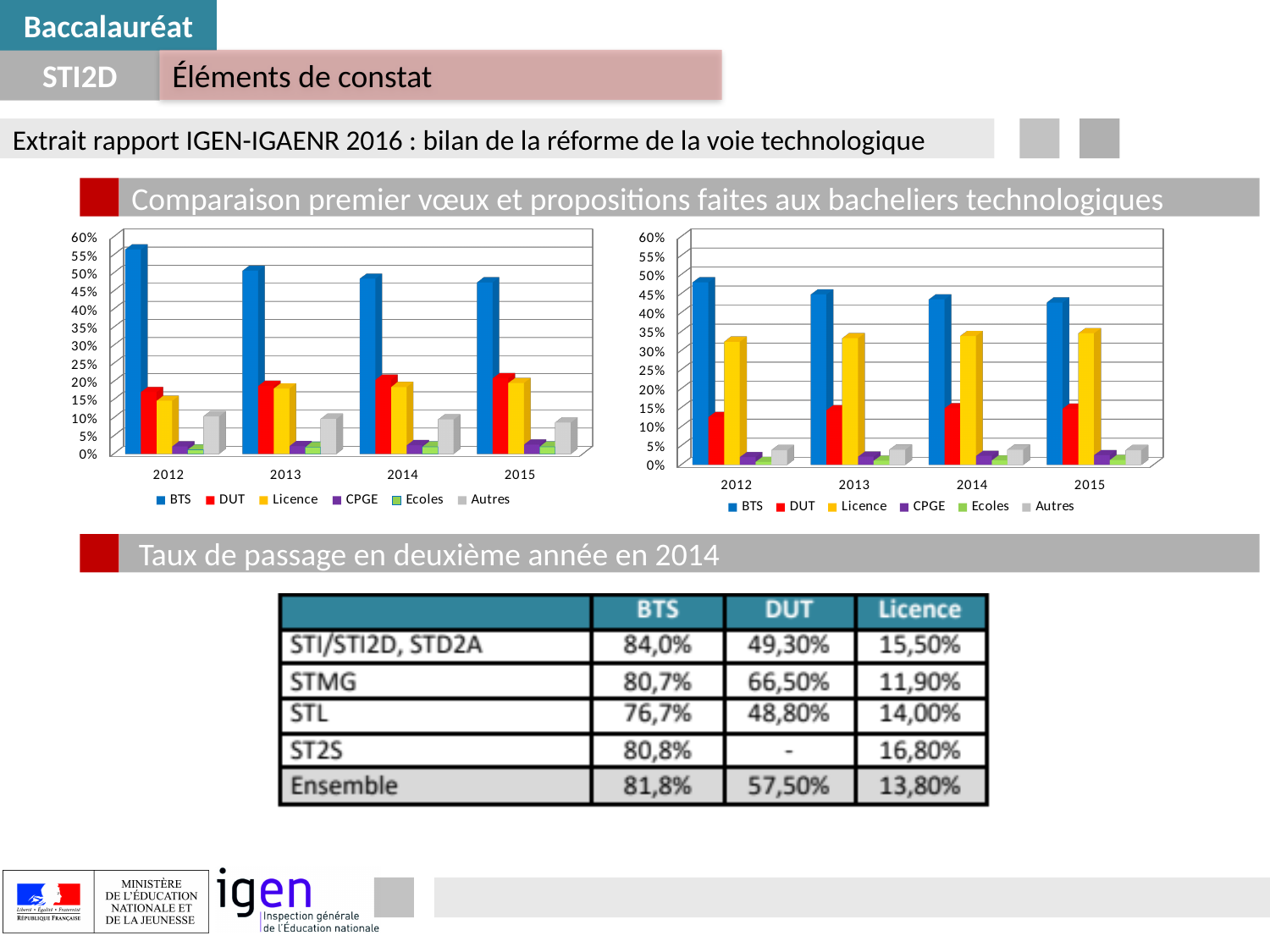
In the left chart, which series has the highest value in 2012? BTS In the right chart, which series has the highest value in 2015? BTS What colour are the BTS bars in the left chart? blue In the left chart, does the BTS value rise or fall from 2012 to 2015? fall In the left chart, is the value for BTS in 2012 greater or less than 55%? greater How many series does the legend of the right chart list? 6 In the left chart, which is larger in 2013, Autres or CPGE? Autres In the right chart, is the value for BTS in 2012 greater or less than 50%? less What kind of chart is the left chart on the slide? bar chart In the right chart, is the value for Licence in 2015 greater or less than 30%? greater How many years are shown on the x axis of the left chart? 4 In the right chart, which is larger in 2014, DUT or Licence? Licence